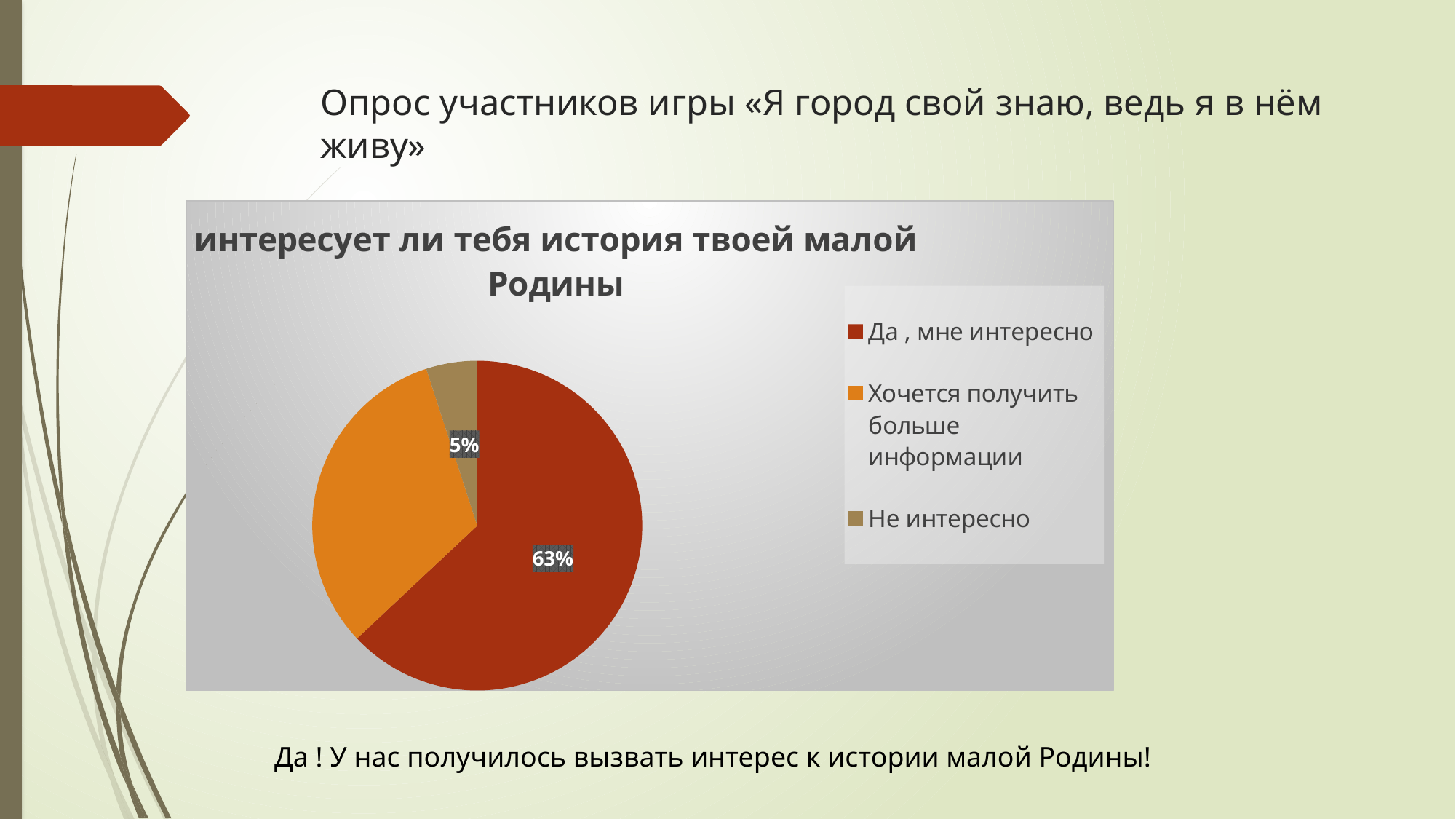
Which is larger: the share for «Да , мне интересно» or the share for «Хочется получить больше информации»? Да , мне интересно By how many percentage points does «Да , мне интересно» exceed «Не интересно»? 58 percentage points What percentage of respondents answered «Да , мне интересно»? 63% Which answer has the largest share of the pie? Да , мне интересно What is the title of the chart? интересует ли тебя история твоей малой Родины What share of the pie does the «Да , мне интересно» slice take? 63% Which colour represents «Хочется получить больше информации» in the legend? Orange What percentage of respondents answered «Не интересно»? 5% How many slices does the pie chart have? 3 What kind of chart is shown on the slide? Pie chart Which answer has the smallest share of the pie? Не интересно Which is larger: the share for «Хочется получить больше информации» or the share for «Не интересно»? Хочется получить больше информации